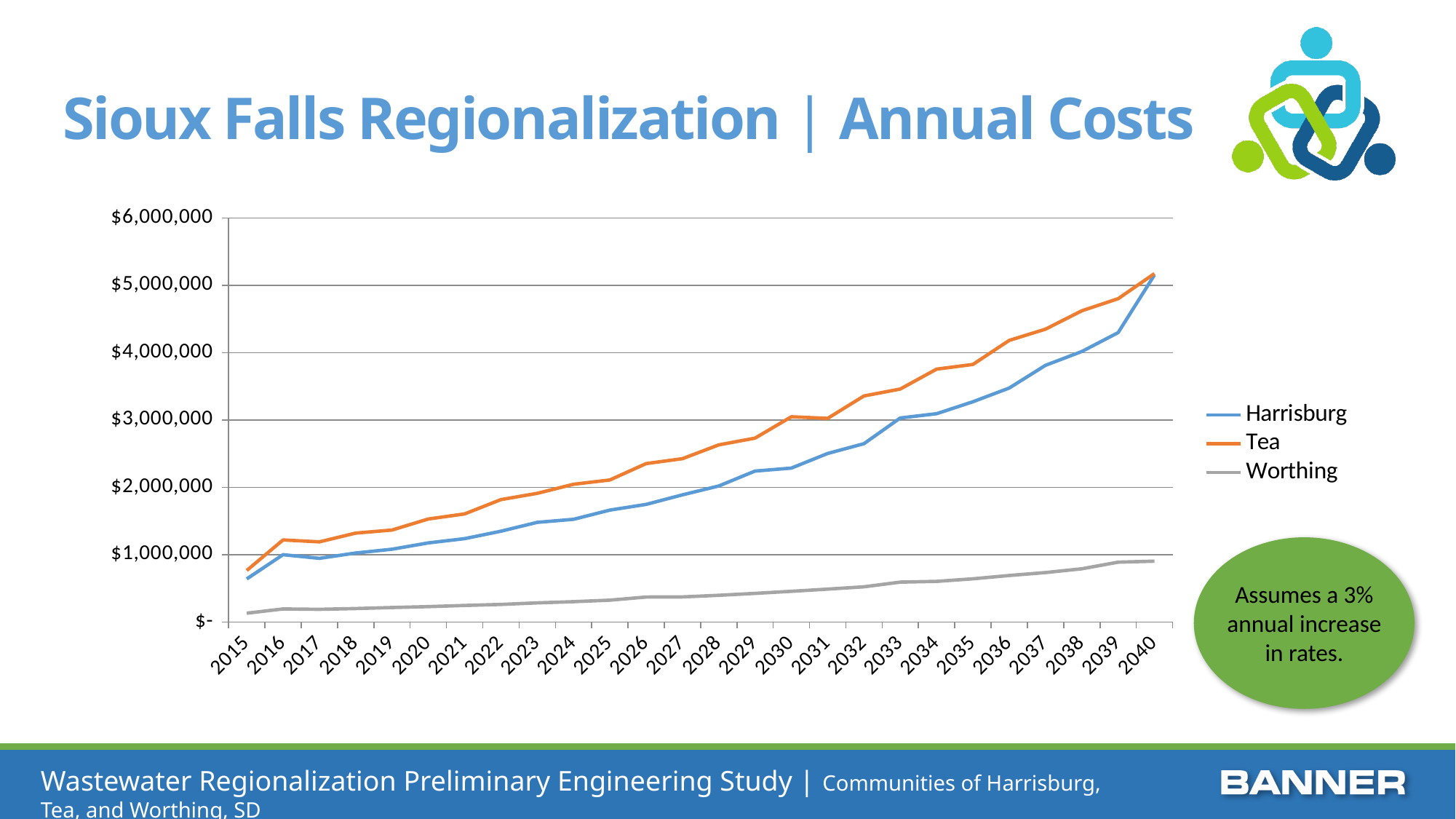
Do the annual costs for Tea rise or fall from 2015 to 2040? rise Which community has the highest annual cost in 2035? Tea In 2030, which is larger: the annual cost for Tea or for Harrisburg? Tea What is the title of the slide containing the chart? Sioux Falls Regionalization | Annual Costs Is the annual cost for Harrisburg in 2030 greater or less than $2,000,000? greater Is the annual cost for Tea in 2036 greater or less than $4,000,000? greater What kind of chart is shown on the slide? line chart How many series does the legend list? 3 Which community has the lowest annual cost in 2035? Worthing Which series is drawn with the orange line? Tea How many years are plotted along the x axis? 26 Is the annual cost for Worthing in 2040 greater or less than $1,000,000? less